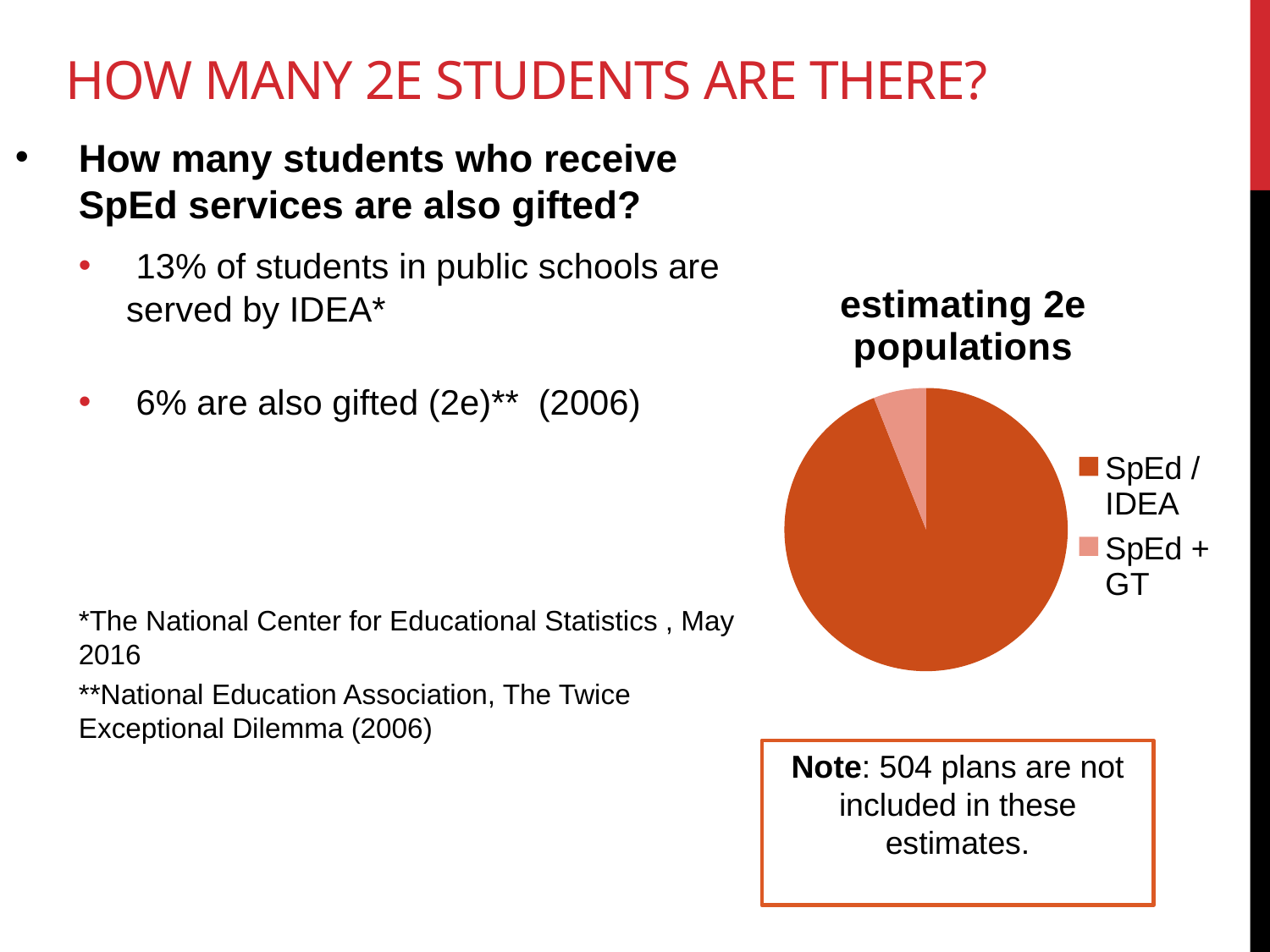
Does the SpEd / IDEA slice take up more or less than half of the pie chart? more Which slice of the pie chart is the largest? SpEd / IDEA Which legend entry is shown in the lighter orange colour in the pie chart? SpEd + GT Which slice of the pie chart is the smallest? SpEd + GT Does the SpEd + GT slice take up more or less than half of the pie chart? less Which slice is larger in the pie chart, SpEd / IDEA or SpEd + GT? SpEd / IDEA How many slices does the pie chart have? 2 What is the title of the pie chart? estimating 2e populations What kind of chart is shown on the slide? pie chart How many entries does the legend of the pie chart list? 2